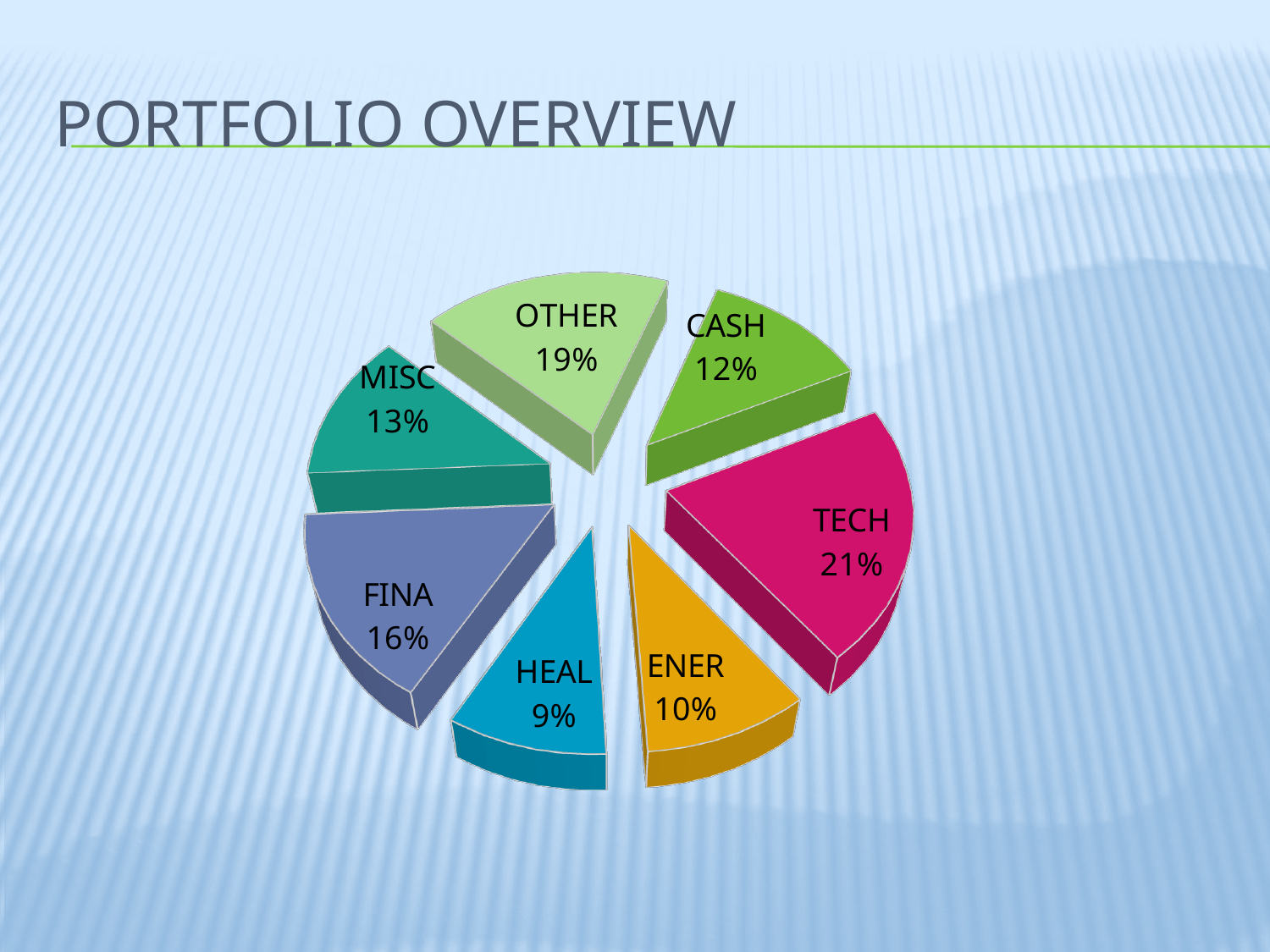
What is the difference between the FINA and MISC shares? 3% What share of the portfolio is HEAL? 9% What kind of chart is shown on the slide? pie chart What colour is the TECH slice? magenta What is the difference between the TECH and CASH shares? 9% How many slices does the pie chart have? 7 What share of the portfolio is OTHER? 19% What share of the portfolio is TECH? 21% What is the title of the slide containing the pie chart? PORTFOLIO OVERVIEW Which category has the smallest slice of the pie? HEAL Which category has the largest slice of the pie? TECH Which is larger, the share for FINA or the share for ENER? FINA